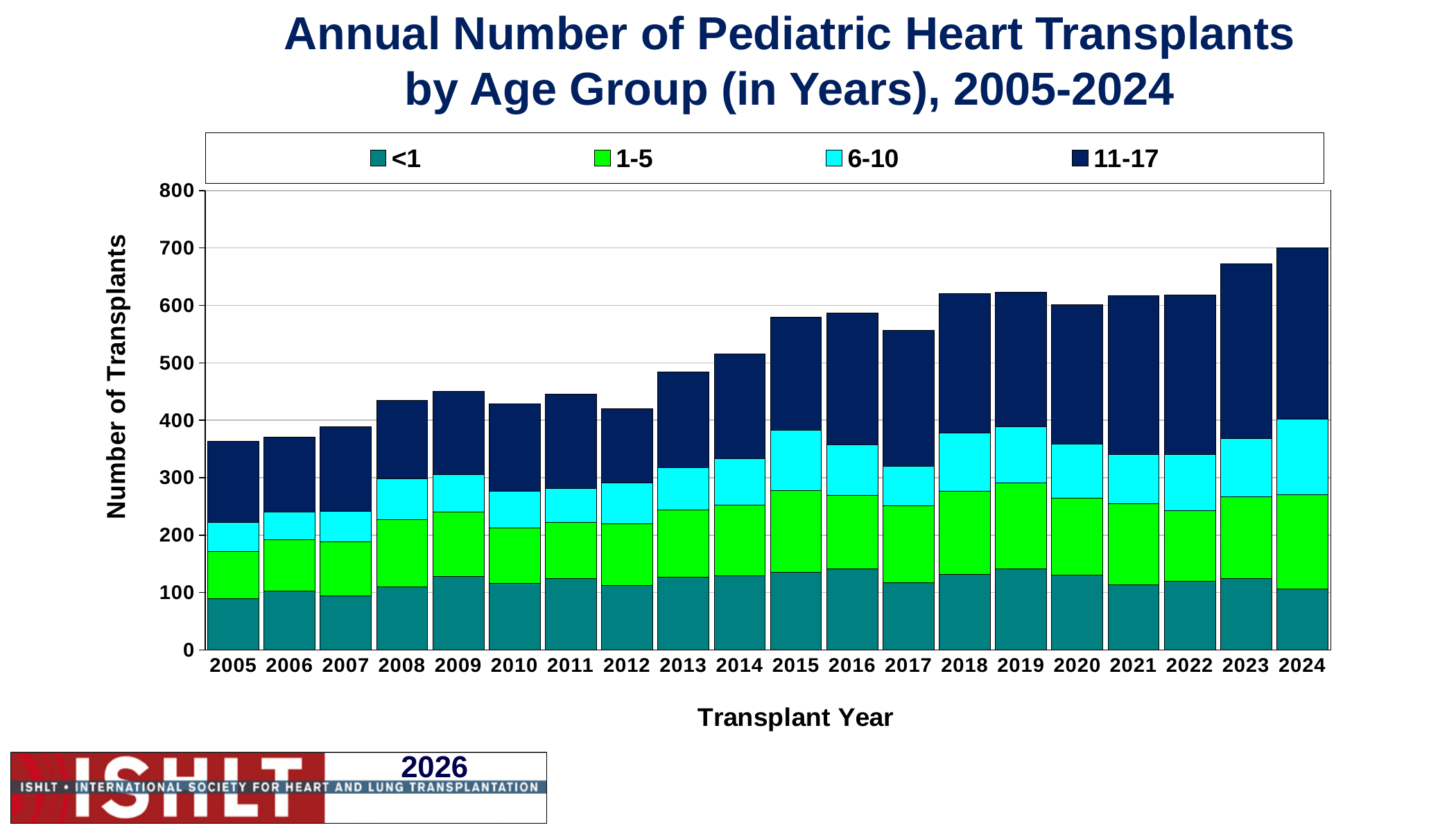
How many transplant years are shown on the x axis? 20 Which year has a larger total number of transplants, 2017 or 2018? 2018 Is the total number of transplants in 2005 greater or less than 400? less Is the total number of transplants in 2024 greater or less than 600? greater Which transplant year has the highest total number of pediatric heart transplants? 2024 Is the total number of transplants in 2012 greater or less than 500? less How many age groups does the legend list? 4 Overall, do the total annual transplant numbers rise or fall from 2005 to 2024? Rise What kind of chart is shown on the slide? Stacked bar chart What are the four age groups listed in the legend? <1, 1-5, 6-10, 11-17 What is the title of the y axis? Number of Transplants